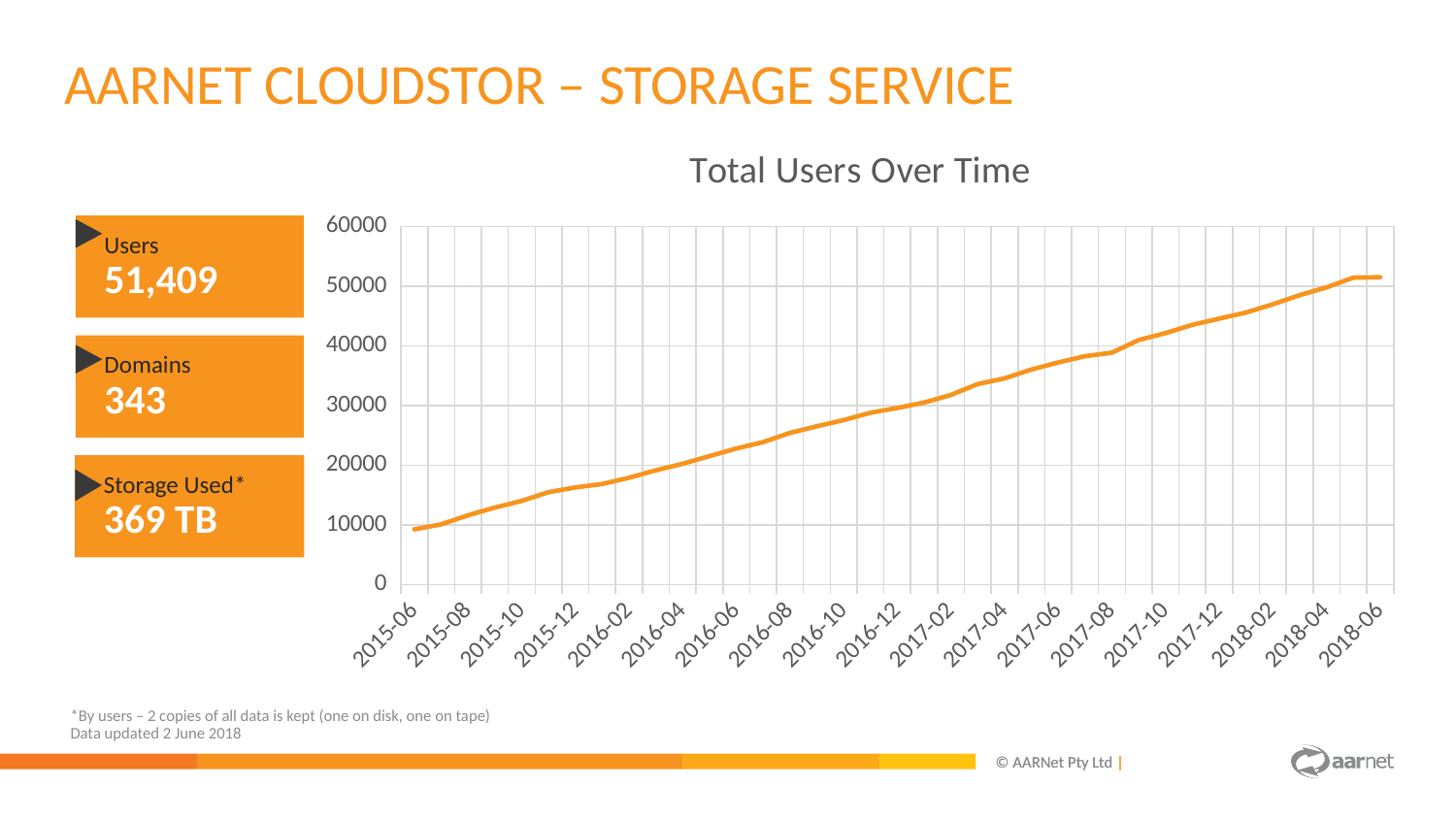
Is the value for 2015-06 greater or less than 10000? less What kind of chart is shown on the slide? line chart Is the value for 2018-06 greater or less than 50000? greater At which date on the x axis is the number of total users highest? 2018-06 Is the value for 2018-02 greater or less than 50000? less At which date on the x axis is the number of total users lowest? 2015-06 How many date labels are shown on the x axis? 19 Do the total users rise or fall over time along the x axis? rise Which has more total users, 2016-02 or 2017-02? 2017-02 What is the title of the chart? Total Users Over Time